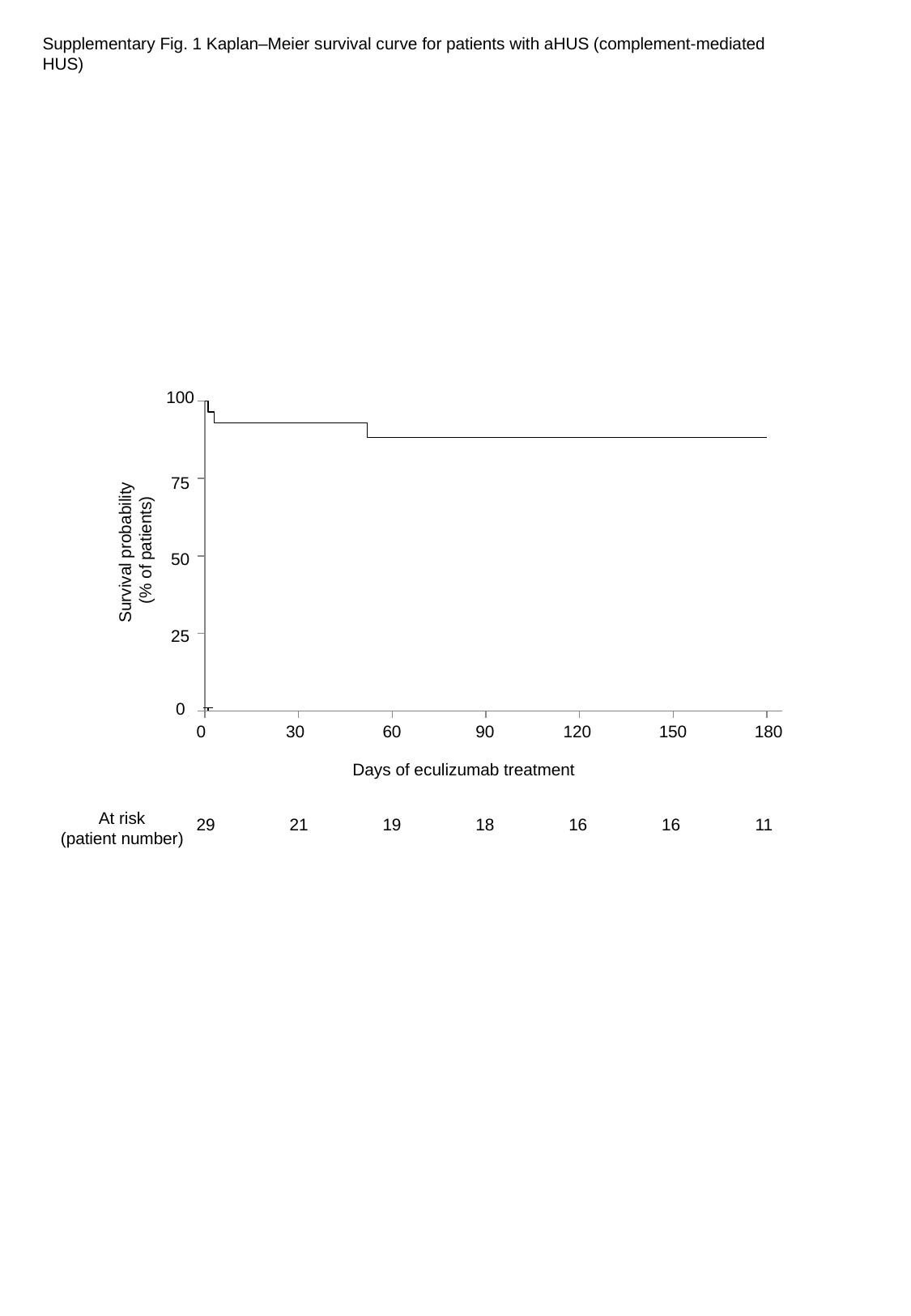
What is the number of patients at risk at day 180? 11 At which day is the number of patients at risk lowest? 180 What is the number of patients at risk at day 0? 29 What kind of chart is shown on the slide? line chart (Kaplan–Meier survival curve) At which day is the number of patients at risk highest? 0 How many time points are listed in the at-risk row? 7 What is the label of the x axis? Days of eculizumab treatment What is the difference between the number of patients at risk at day 0 and at day 30? 8 Does the survival probability rise or fall as days of eculizumab treatment increase? fall What is the number of patients at risk at day 90? 18 Is the survival probability at day 180 greater or less than 75? greater Is the number of patients at risk larger at day 60 or at day 120? day 60